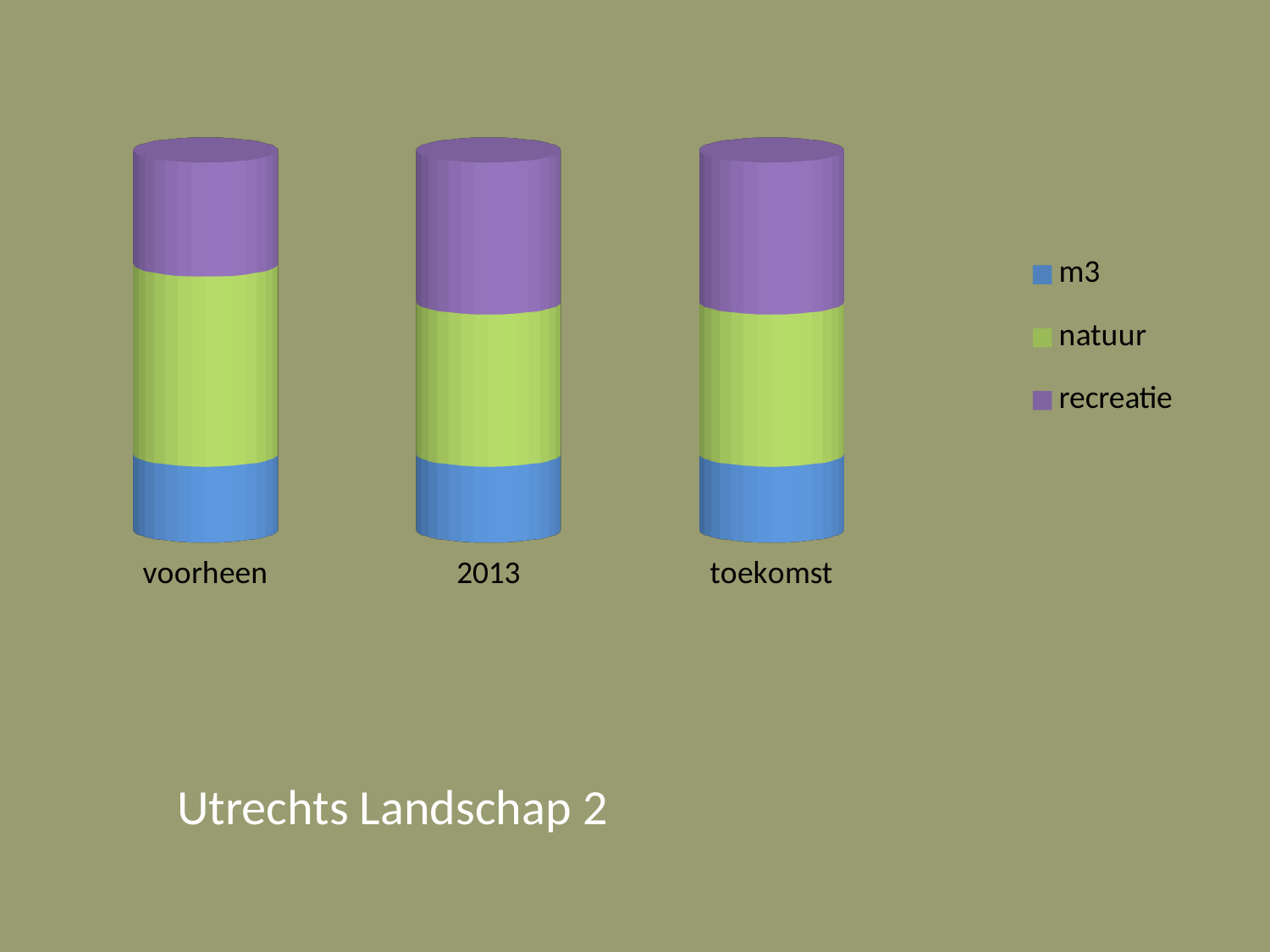
Which series forms the smallest segment of the voorheen bar? m3 Which series forms the largest segment of the voorheen bar? natuur What kind of chart is shown on the slide? Stacked bar chart Which series forms the smallest segment of the toekomst bar? m3 Which series is shown in blue in the chart? m3 Is the natuur segment larger in the voorheen bar or in the 2013 bar? voorheen Which category is shown first on the x axis of the chart? voorheen How many categories are shown along the x axis of the chart? 3 Which series is shown in purple in the chart? recreatie Does the recreatie segment increase or decrease from voorheen to 2013? increase Is the recreatie segment larger in the voorheen bar or in the 2013 bar? 2013 How many series does the chart's legend list? 3